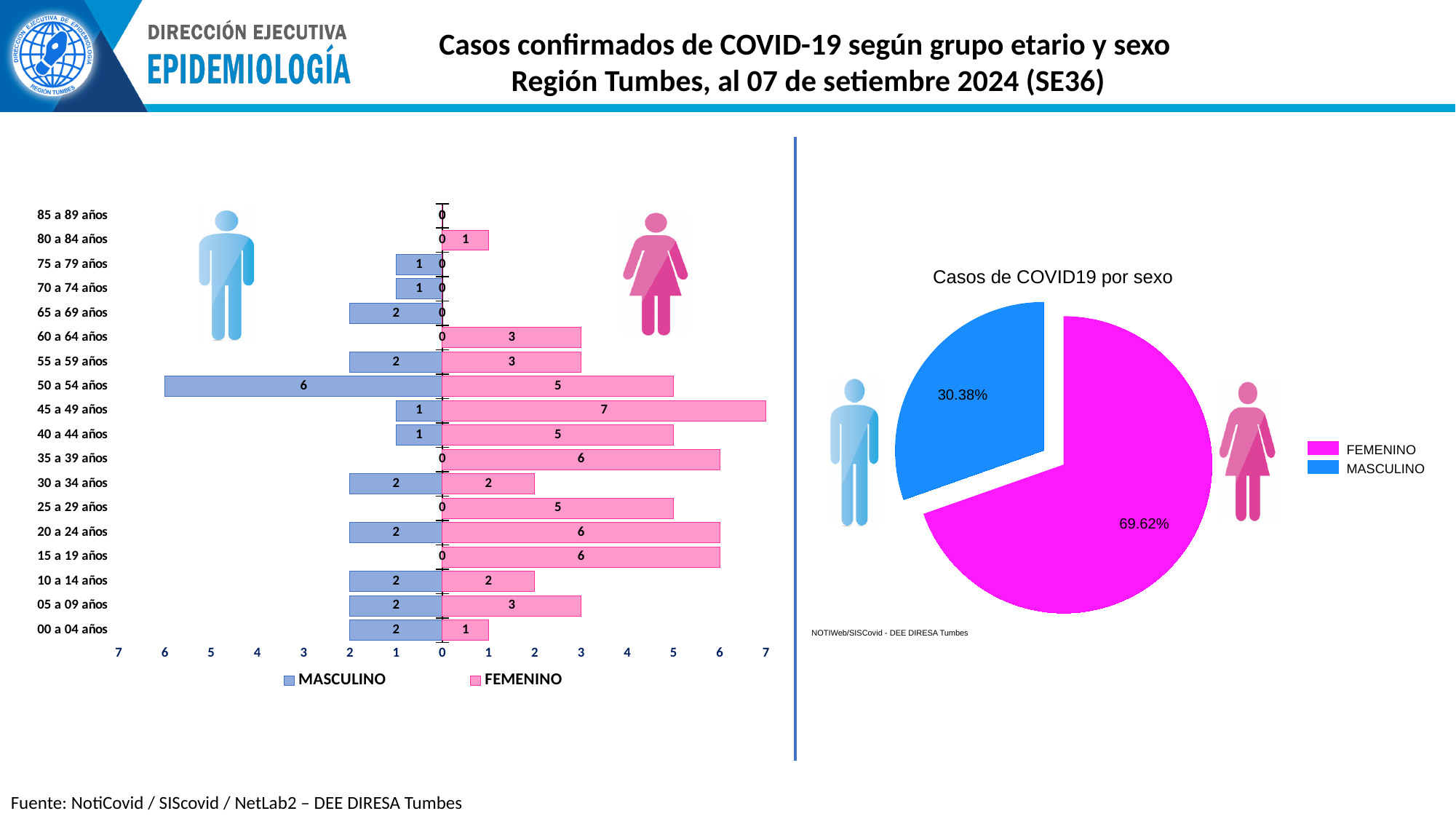
What kind of chart is the chart on the left of the slide? Bar chart In the left bar chart, what is the FEMENINO value for the 45 a 49 años group? 7 In the left bar chart, how many series does the legend list? 2 In the left bar chart, which age group has the highest FEMENINO value? 45 a 49 años In the left bar chart, what is the difference between the FEMENINO and MASCULINO values for the 20 a 24 años group? 4 In the left bar chart, what is the MASCULINO value for the 50 a 54 años group? 6 What is the title of the pie chart on the right of the slide? Casos de COVID19 por sexo In the pie chart 'Casos de COVID19 por sexo', what share is FEMENINO? 69.62% In the left bar chart, how many age groups are shown? 18 In the left bar chart, which is larger for the 50 a 54 años group, MASCULINO or FEMENINO? MASCULINO In the left bar chart, which age group has the highest MASCULINO value? 50 a 54 años In the pie chart 'Casos de COVID19 por sexo', what share is MASCULINO? 30.38%